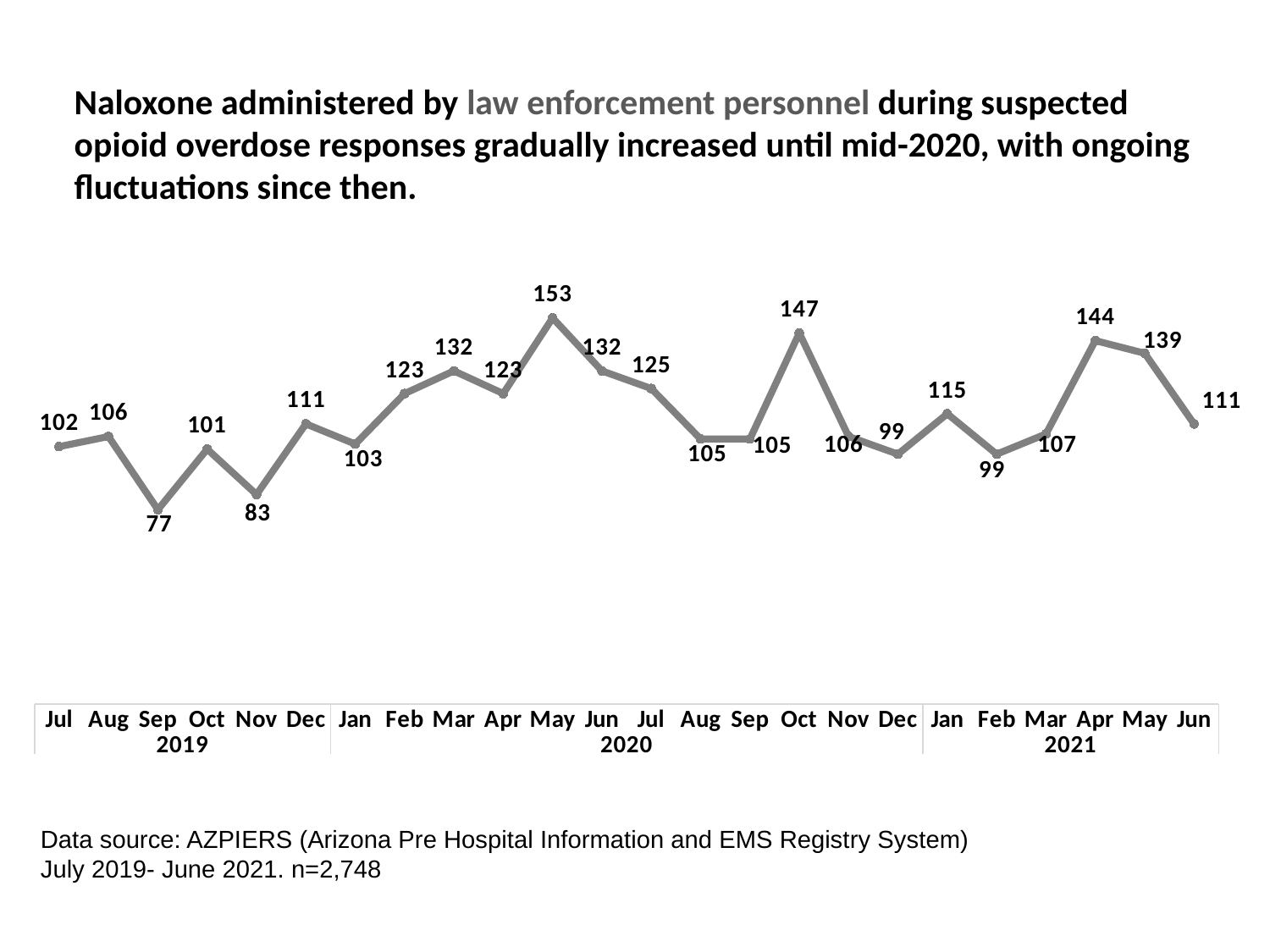
What value is shown for September 2019? 77 What kind of chart is shown on the slide? Line chart What is the difference between the values for April 2021 and March 2021? 37 Which month has the highest value on the chart? May 2020 Which is larger, the value for October 2020 or the value for April 2021? October 2020 How many monthly data points are plotted on the chart? 24 What value is shown for October 2020? 147 What is the difference between the values for May 2020 and September 2019? 76 Which month has the lowest value on the chart? Sep 2019 Do the values rise or fall from February 2021 to April 2021? Rise What value is shown for May 2020? 153 What value is shown for June 2021? 111